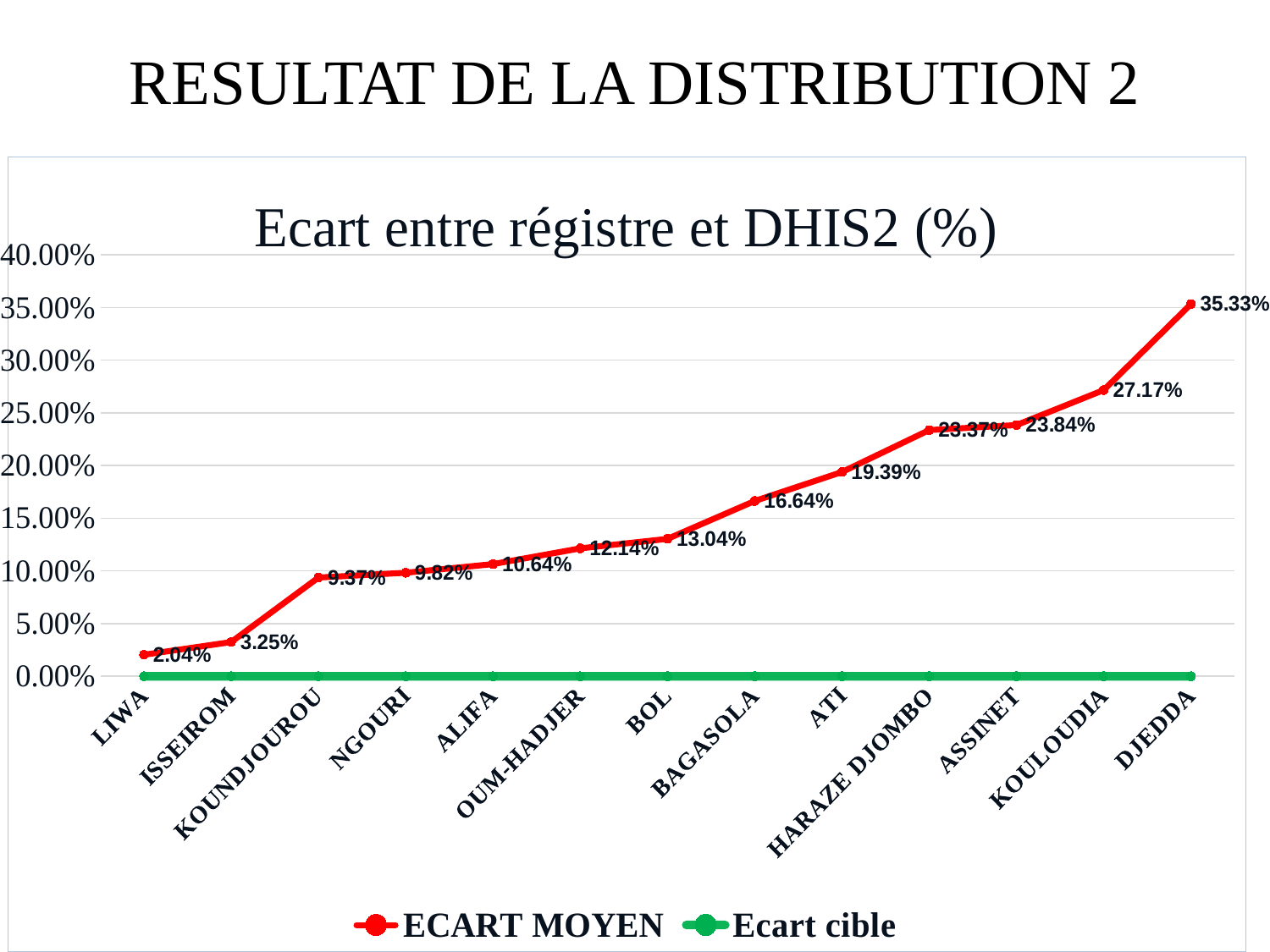
What is the ECART MOYEN value for HARAZE DJOMBO? 23.37% What is the ECART MOYEN value for BOL? 13.04% What is the title of the chart? Ecart entre régistre et DHIS2 (%) Do the ECART MOYEN values rise or fall from LIWA to DJEDDA? Rise How many series does the legend list? 2 Which category has the highest ECART MOYEN value? DJEDDA Which category has the lowest ECART MOYEN value? LIWA Which has a larger ECART MOYEN value, ATI or BAGASOLA? ATI What kind of chart is shown on the slide? Line chart How many categories are shown on the x axis? 13 What is the ECART MOYEN value for DJEDDA? 35.33% What is the difference between the ECART MOYEN values for DJEDDA and KOULOUDIA? 8.16%